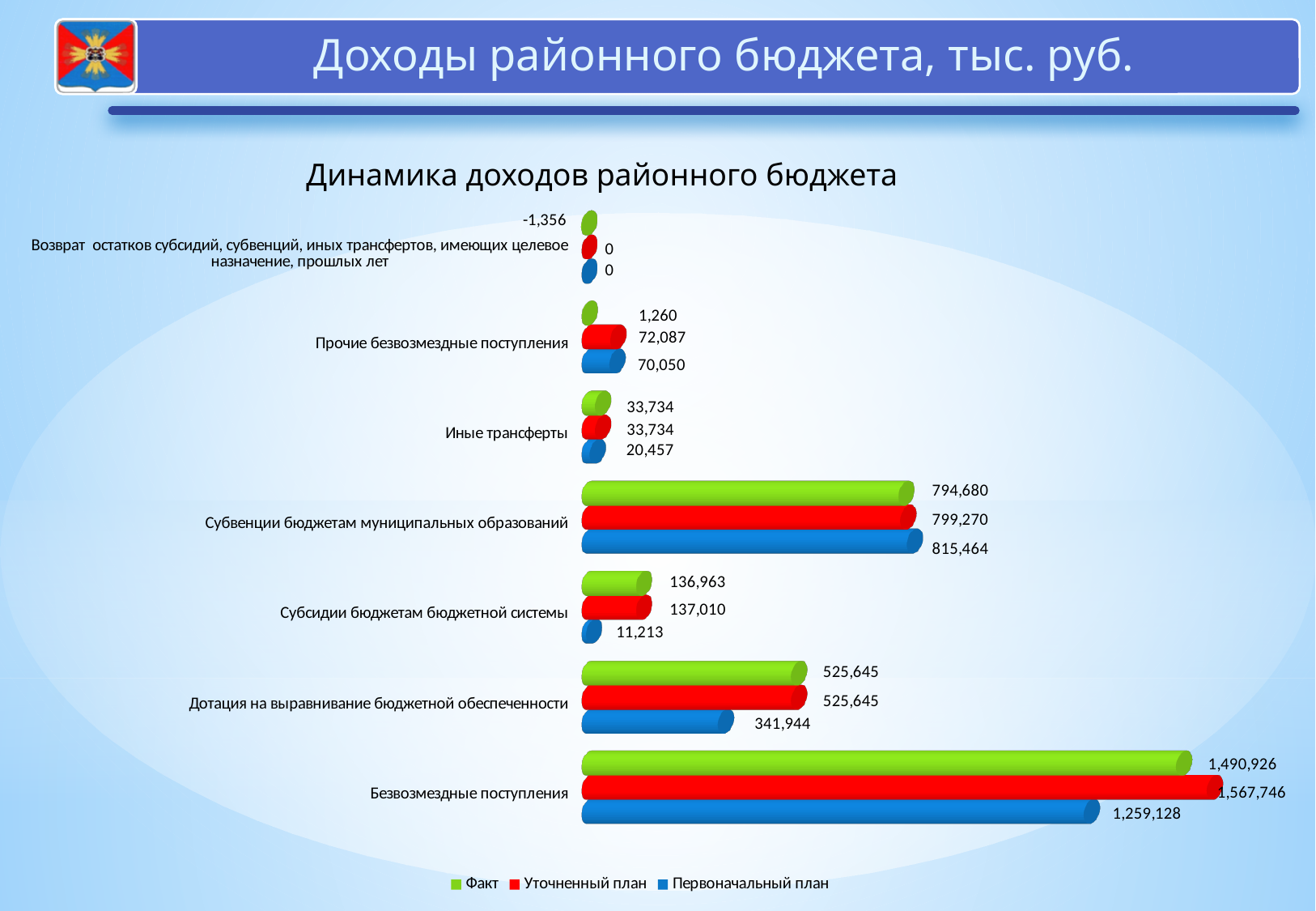
Which category has the highest Уточненный план value? Безвозмездные поступления What is the difference between the Уточненный план and Первоначальный план values for Безвозмездные поступления? 308,618 What is the chart title? Динамика доходов районного бюджета How many categories are shown in the chart? 7 For Субсидии бюджетам бюджетной системы, which is larger: the Факт value or the Первоначальный план value? Факт What is the Факт value for Безвозмездные поступления? 1,490,926 What is the Факт value for Возврат остатков субсидий, субвенций, иных трансфертов, имеющих целевое назначение, прошлых лет? -1,356 How many series does the legend list? 3 What type of chart is shown on the slide? bar chart Which category has the lowest Первоначальный план value? Возврат остатков субсидий, субвенций, иных трансфертов, имеющих целевое назначение, прошлых лет What is the Первоначальный план value for Дотация на выравнивание бюджетной обеспеченности? 341,944 What is the Уточненный план value for Субвенции бюджетам муниципальных образований? 799,270